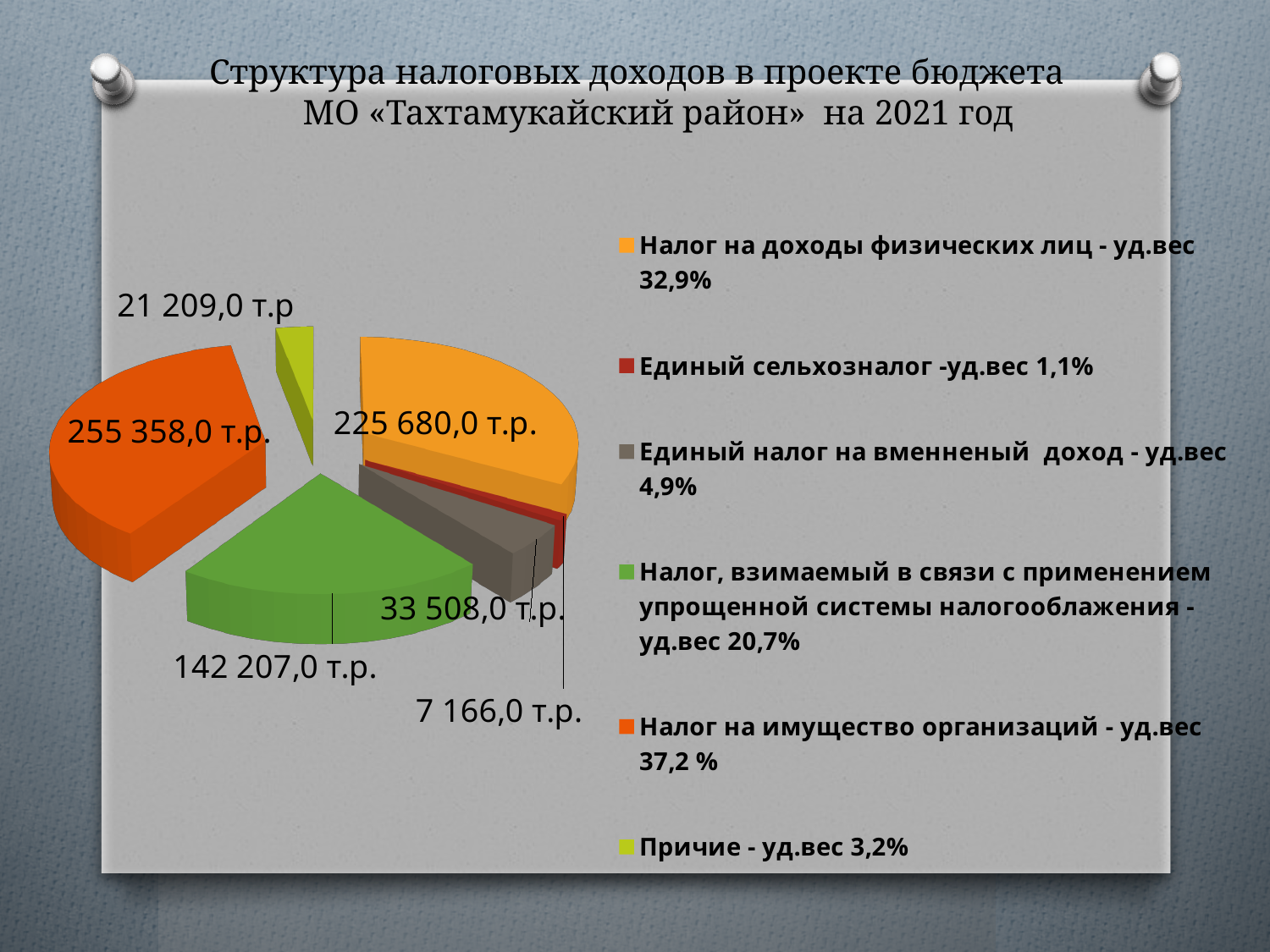
What share of the pie does Причие represent? 3,2% What is the difference between the values for Налог на имущество организаций and Налог на доходы физических лиц? 29 678,0 т.р. How many slices does the pie chart have? 6 What is the value for Налог на имущество организаций? 255 358,0 т.р. What is the value for Налог, взимаемый в связи с применением упрощенной системы налогооблажения? 142 207,0 т.р. What is the value for Налог на доходы физических лиц? 225 680,0 т.р. What type of chart is shown on the slide? Pie chart What is the value for Единый сельхозналог? 7 166,0 т.р. Which category has the largest slice of the pie? Налог на имущество организаций Which category has the smallest slice of the pie? Единый сельхозналог What share of the pie does Единый налог на вменненый доход represent? 4,9% Which is larger: the value for Единый налог на вменненый доход or the value for Причие? Единый налог на вменненый доход